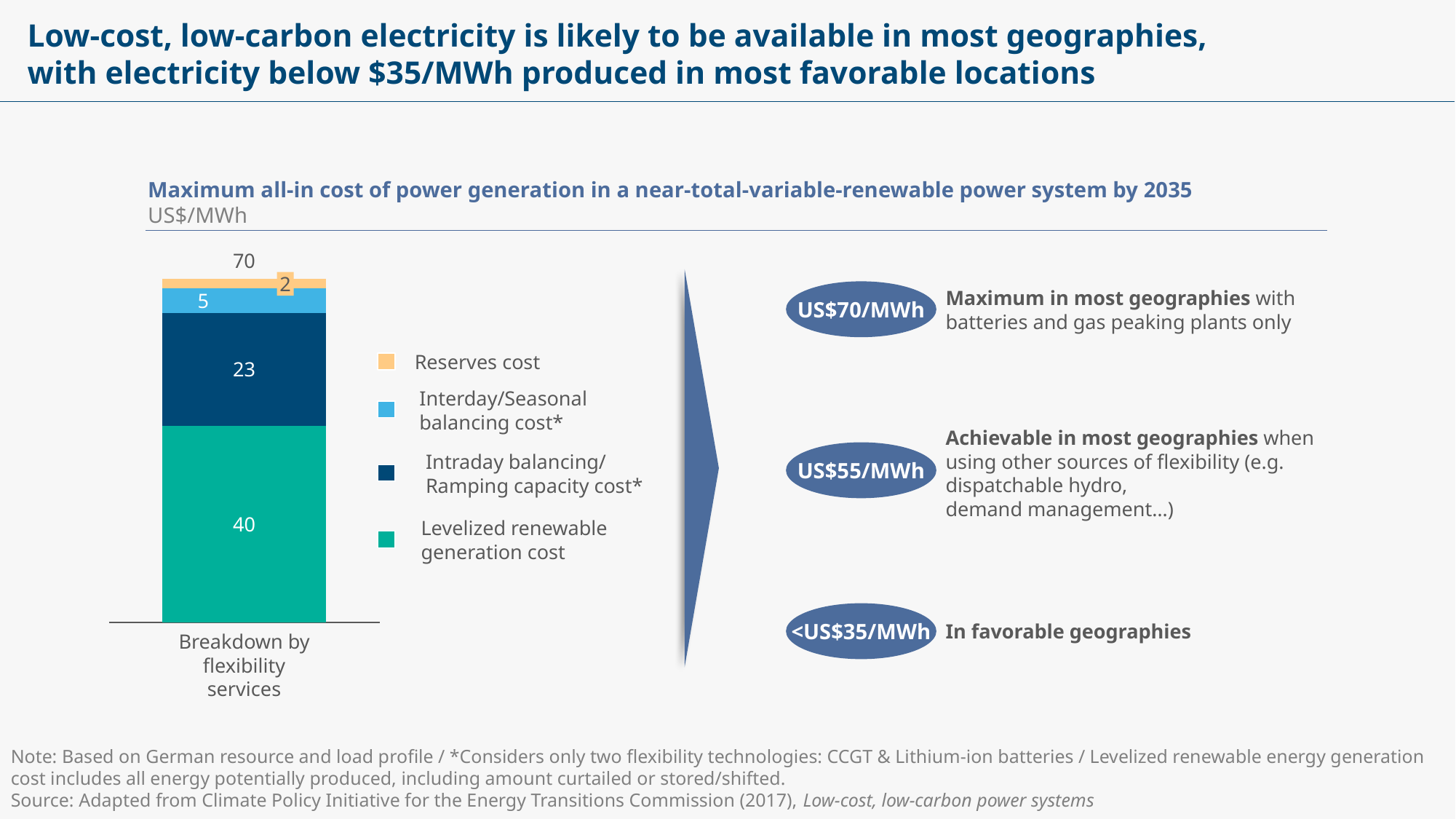
Which segment of the stacked bar is the smallest? Reserves cost What is the value of the Interday/Seasonal balancing cost segment? 5 What is the value of the Intraday balancing/Ramping capacity cost segment? 23 What is the total of the stacked bar labelled 'Breakdown by flexibility services'? 70 Which segment of the stacked bar is the largest? Levelized renewable generation cost What is the value of the Reserves cost segment? 2 How many series does the legend list? 4 What unit is the chart measured in, as stated under the chart title? US$/MWh What kind of chart is shown on the slide? Stacked bar chart Which is larger: the Interday/Seasonal balancing cost or the Reserves cost? Interday/Seasonal balancing cost What is the difference between the Levelized renewable generation cost and the Intraday balancing/Ramping capacity cost? 17 What is the value of the Levelized renewable generation cost segment in the stacked bar? 40